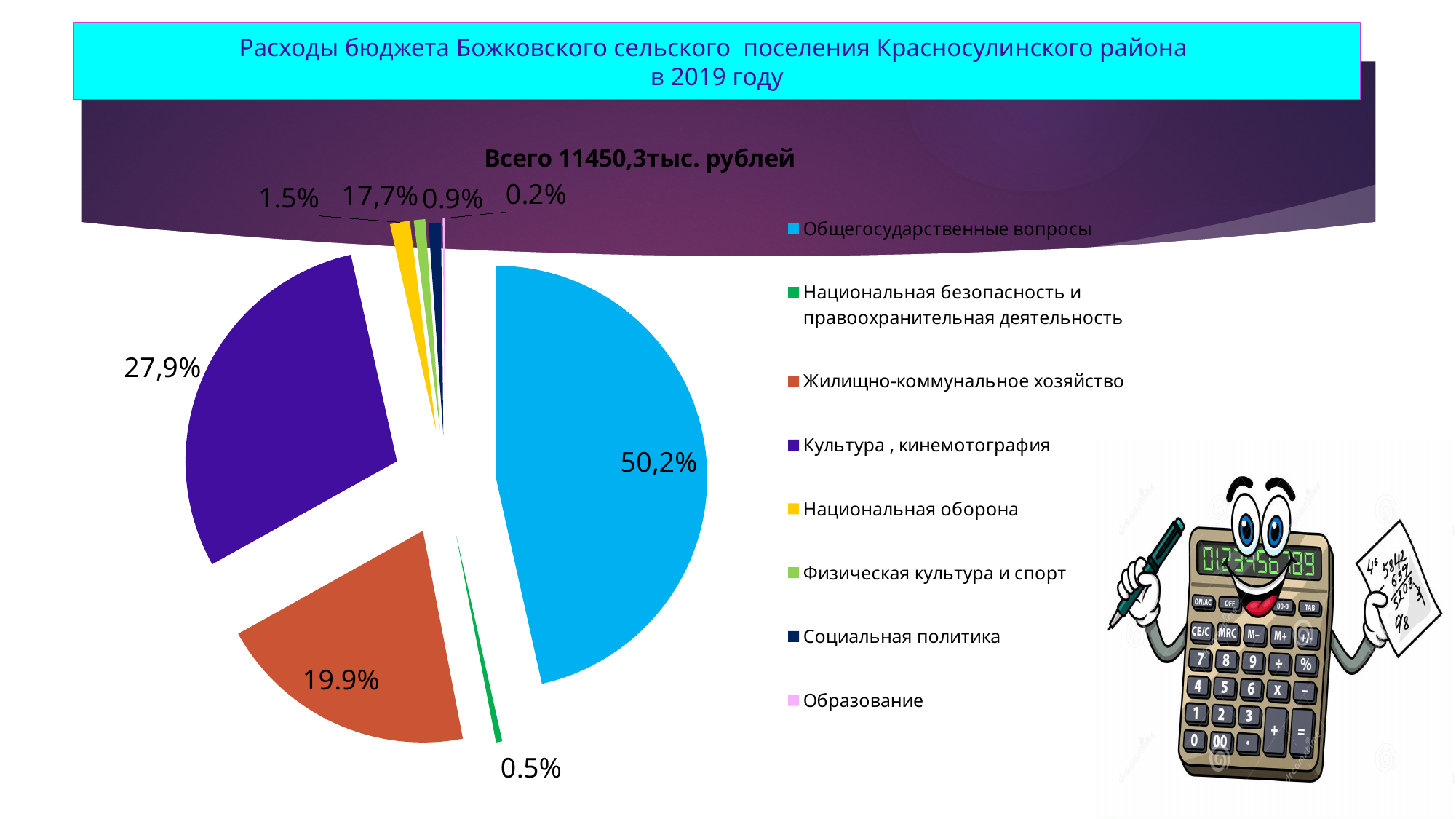
What share of the budget expenses goes to Национальная оборона? 1.5% What total amount of expenses is stated above the pie chart? 11450,3 тыс. рублей Which category has the largest share of the budget expenses? Общегосударственные вопросы What share of the budget expenses goes to Жилищно-коммунальное хозяйство? 19.9% What kind of chart is shown on the slide? pie chart What is the difference in percentage points between Общегосударственные вопросы and Культура, кинемотография? 22,3% What share of the budget expenses goes to Общегосударственные вопросы? 50,2% What share of the budget expenses goes to Национальная безопасность и правоохранительная деятельность? 0.5% What share of the budget expenses goes to Культура, кинемотография? 27,9% How many categories does the legend list? 8 Which has a larger share: Жилищно-коммунальное хозяйство or Культура, кинемотография? Культура, кинемотография What colour is the slice for Общегосударственные вопросы? light blue